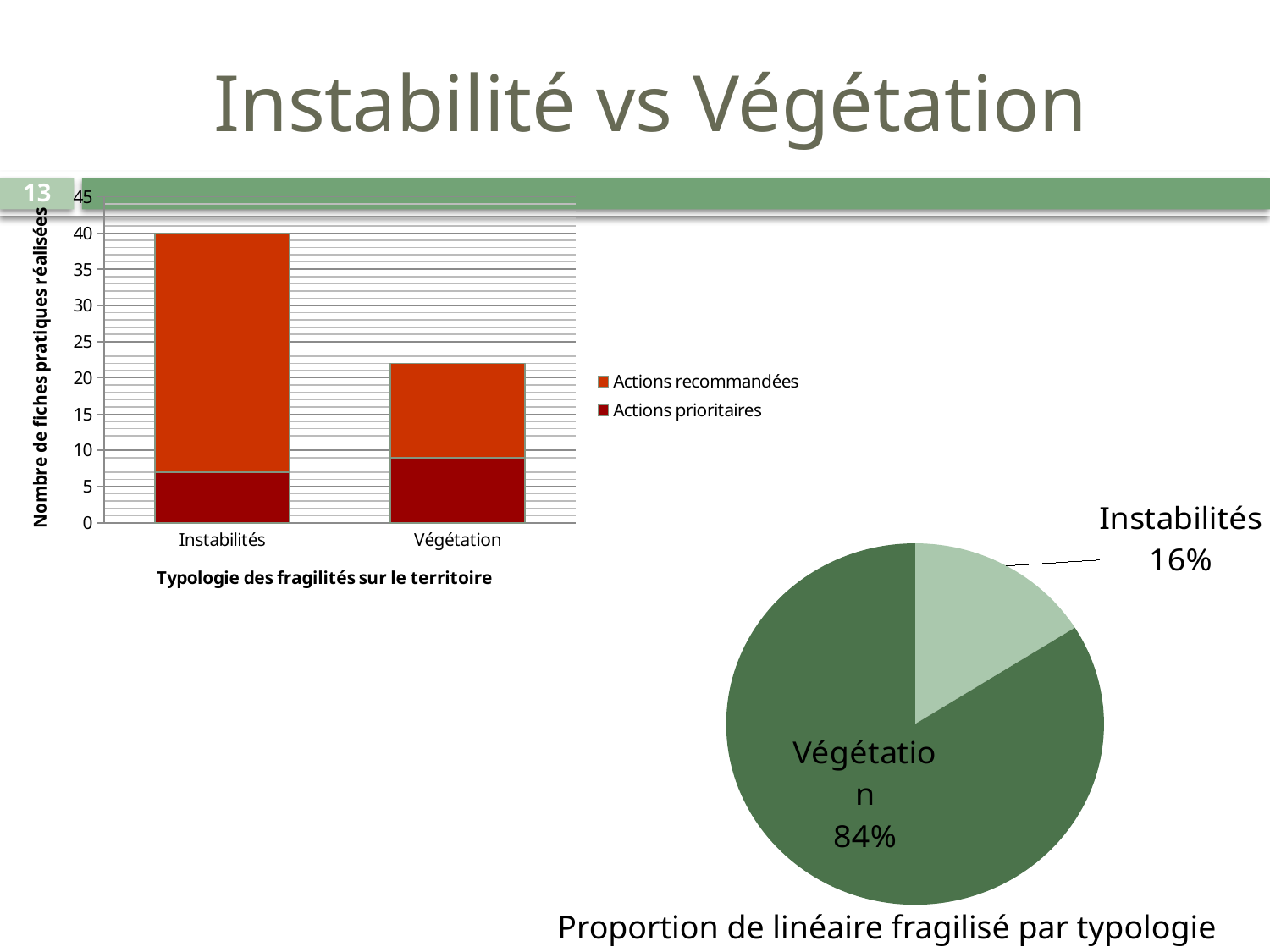
In the bar chart on the left, how many series does the legend list? 2 In the bar chart on the left, how many categories are shown on the x axis? 2 In the bar chart on the left, is the total height of the Instabilités bar greater or less than 35? greater In the pie chart 'Proportion de linéaire fragilisé par typologie', which slice is the largest? Végétation In the bar chart on the left, what is the label of the y axis? Nombre de fiches pratiques réalisées What kind of chart is the chart titled 'Proportion de linéaire fragilisé par typologie'? pie chart In the pie chart 'Proportion de linéaire fragilisé par typologie', what share does Végétation have? 84% In the bar chart on the left, is the total height of the Végétation bar greater or less than 25? less In the bar chart on the left, is the Actions prioritaires value for Végétation greater or less than 5? greater In the bar chart on the left, which category has the taller stacked bar? Instabilités In the pie chart 'Proportion de linéaire fragilisé par typologie', what share does Instabilités have? 16% What kind of chart is the chart on the left of the slide? bar chart